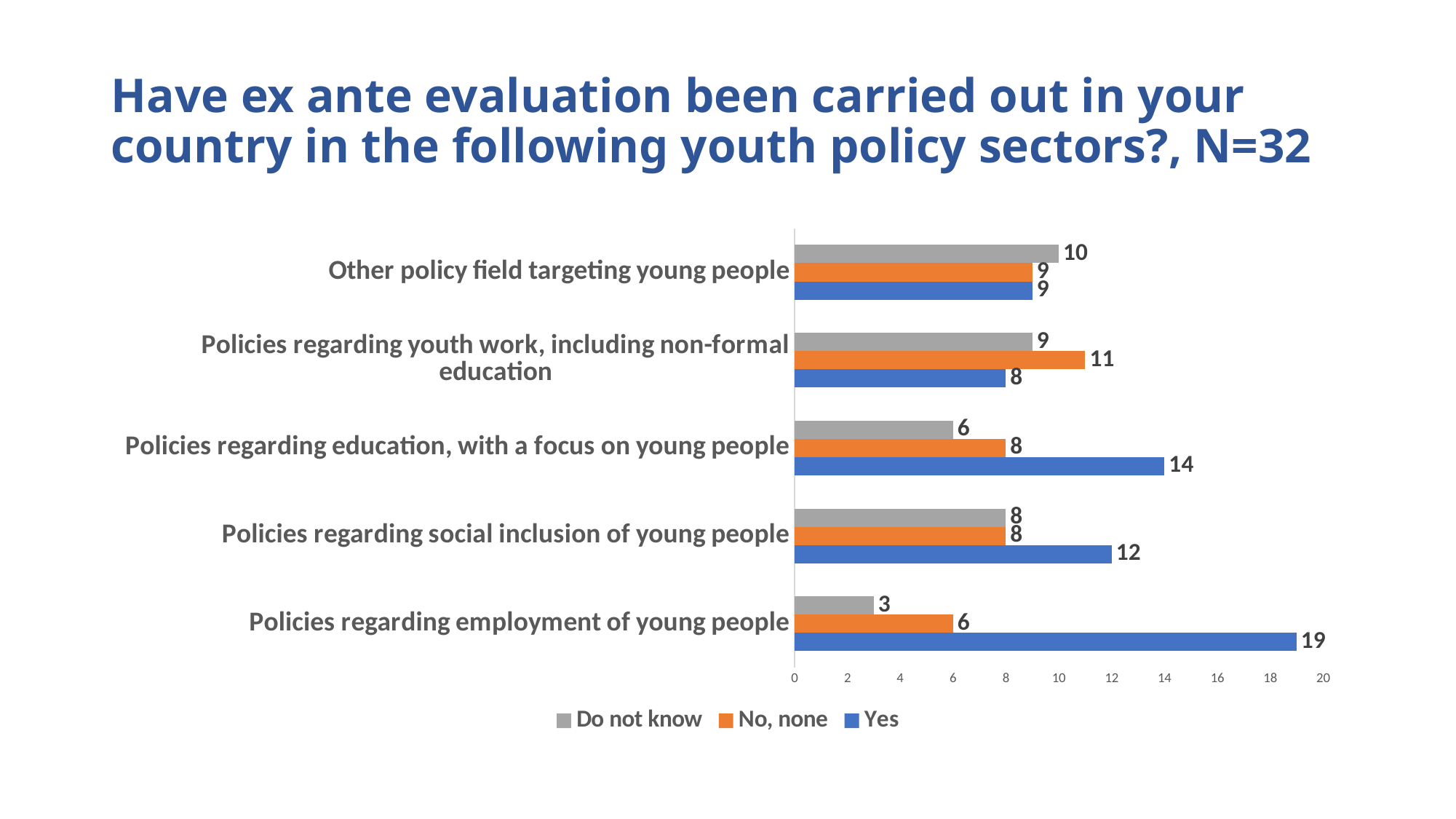
For Policies regarding youth work, including non-formal education, which is larger: the 'Yes' value or the 'No, none' value? No, none How many series does the legend list? 3 What is the total of the three values for Policies regarding social inclusion of young people? 28 What is the difference between the 'Yes' and 'No, none' values for Policies regarding employment of young people? 13 What is the 'Do not know' value for Policies regarding education, with a focus on young people? 6 How many policy sectors are shown on the chart? 5 Which colour represents the 'Yes' series in the legend? Blue What is the 'No, none' value for Policies regarding youth work, including non-formal education? 11 What is the 'Yes' value for Policies regarding employment of young people? 19 What kind of chart is shown on the slide? Bar chart Which policy sector has the highest 'Yes' value? Policies regarding employment of young people Which policy sector has the lowest 'Do not know' value? Policies regarding employment of young people